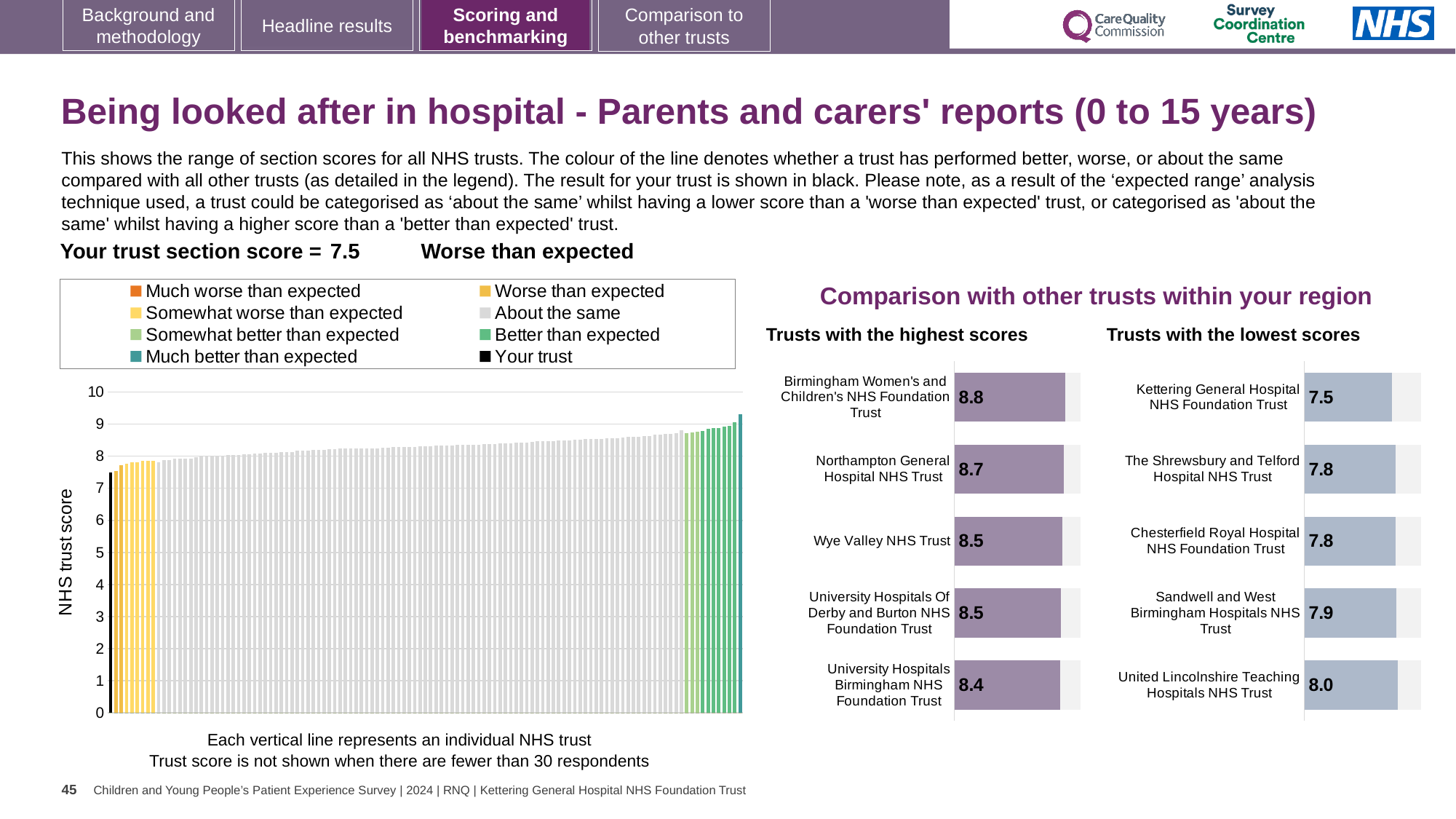
In the 'Trusts with the lowest scores' chart, which has the larger score: Sandwell and West Birmingham Hospitals NHS Trust or Kettering General Hospital NHS Foundation Trust? Sandwell and West Birmingham Hospitals NHS Trust In the 'Trusts with the highest scores' chart, which trust has the highest score? Birmingham Women's and Children's NHS Foundation Trust In the 'Trusts with the lowest scores' chart, what is the score for Kettering General Hospital NHS Foundation Trust? 7.5 What kind of chart is the large chart on the left showing the range of section scores for all NHS trusts? bar chart In the large chart on the left, how many entries does the legend list? 8 In the 'Trusts with the highest scores' chart, how many trusts are shown? 5 In the large chart on the left, do the trust scores rise or fall from left to right? rise In the 'Trusts with the lowest scores' chart, what is the difference between the scores of United Lincolnshire Teaching Hospitals NHS Trust and Kettering General Hospital NHS Foundation Trust? 0.5 In the 'Trusts with the highest scores' chart, what is the score for Birmingham Women's and Children's NHS Foundation Trust? 8.8 In the 'Trusts with the lowest scores' chart, what is the score for The Shrewsbury and Telford Hospital NHS Trust? 7.8 In the 'Trusts with the lowest scores' chart, which trust has the lowest score? Kettering General Hospital NHS Foundation Trust In the 'Trusts with the highest scores' chart, what is the difference between the scores of Birmingham Women's and Children's NHS Foundation Trust and University Hospitals Birmingham NHS Foundation Trust? 0.4